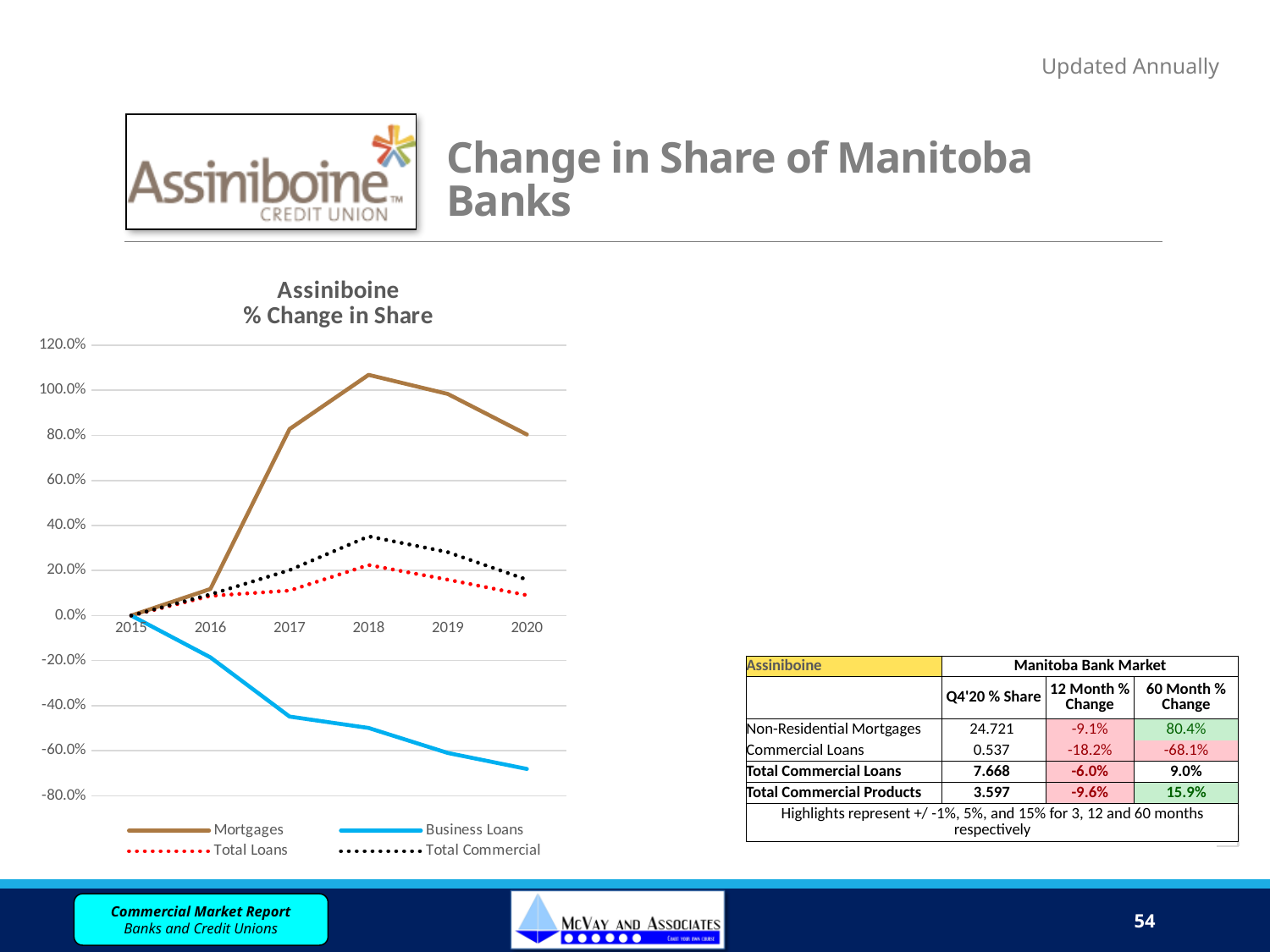
How many series does the legend of the "Assiniboine % Change in Share" chart list? 4 How many years are shown on the x axis of the "Assiniboine % Change in Share" chart? 6 In the "Assiniboine % Change in Share" chart, which is larger in 2018: Total Commercial or Total Loans? Total Commercial In the "Assiniboine % Change in Share" chart, is the value for Mortgages in 2018 greater or less than 100.0%? greater In the "Assiniboine % Change in Share" chart, is the value for Total Commercial in 2018 greater or less than 20.0%? greater In the "Assiniboine % Change in Share" chart, what is the value for Mortgages in 2015? 0.0% What kind of chart is the "Assiniboine % Change in Share" chart? line chart In the "Assiniboine % Change in Share" chart, is the value for Business Loans in 2020 greater or less than -60.0%? less In the "Assiniboine % Change in Share" chart, which series has the highest value in 2018? Mortgages In the "Assiniboine % Change in Share" chart, which series has the lowest value in 2020? Business Loans In the "Assiniboine % Change in Share" chart, does the Business Loans line rise or fall from 2015 to 2020? fall In the "Assiniboine % Change in Share" chart, what colour is the Mortgages line? brown